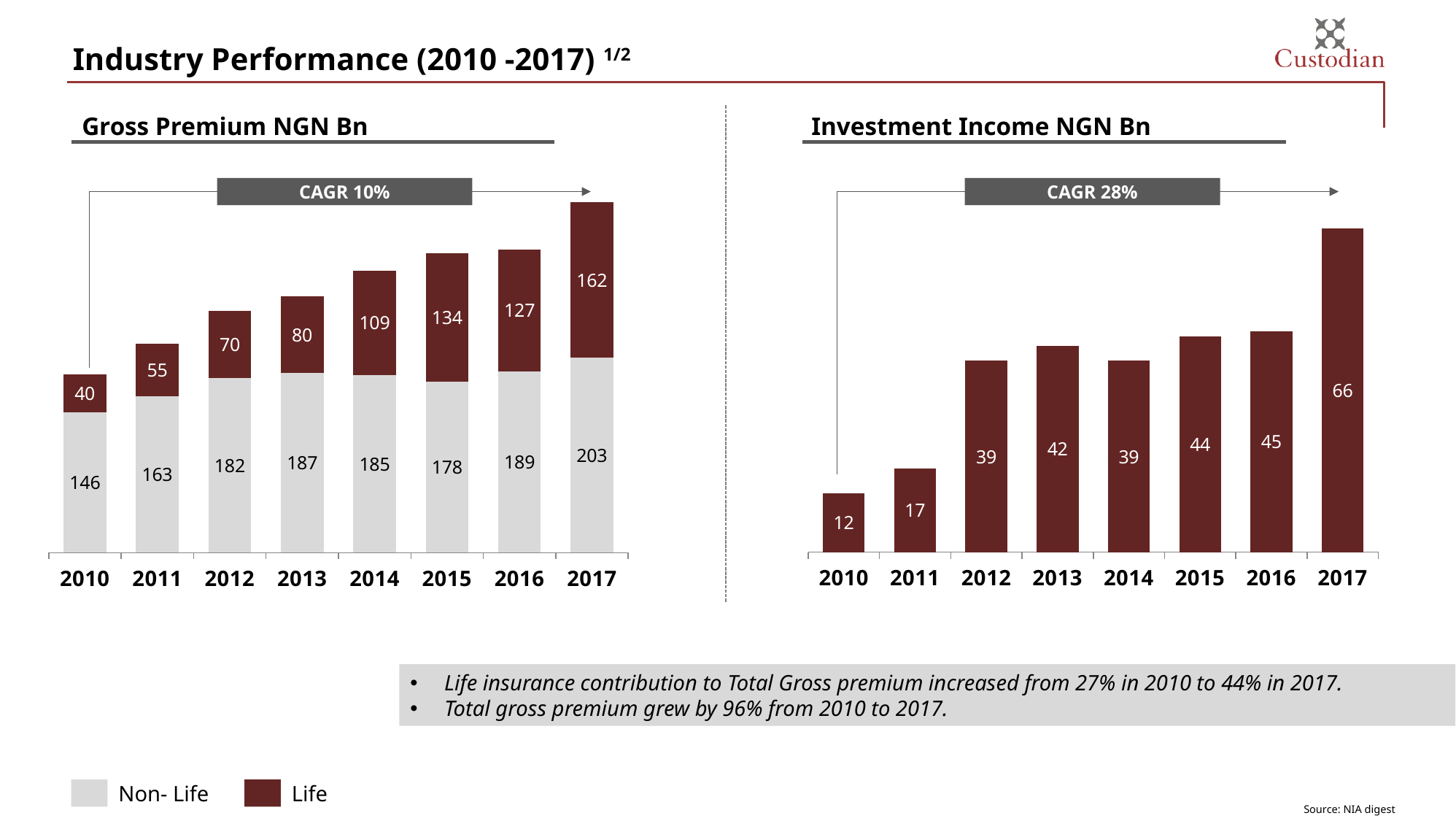
In the Gross Premium NGN Bn chart, which year has the highest Life value? 2017 In the Gross Premium NGN Bn chart, which year has the lowest Non-Life value? 2010 In the Gross Premium NGN Bn chart, what is the difference between the Non-Life values for 2016 and 2015? 11 In the Gross Premium NGN Bn chart, what is the Life value for 2017? 162 In the Investment Income NGN Bn chart, how many years are shown on the x axis? 8 In the Investment Income NGN Bn chart, what is the difference between the 2017 and 2016 values? 21 In the Gross Premium NGN Bn chart, what is the total gross premium for 2010? 186 In the Gross Premium NGN Bn chart, what is the total gross premium for 2017? 365 In the Gross Premium NGN Bn chart, what is the Non-Life value for 2013? 187 What CAGR is shown on the Investment Income NGN Bn chart? CAGR 28% In the Investment Income NGN Bn chart, which year has the lowest value? 2010 In the Investment Income NGN Bn chart, what is the value for 2013? 42